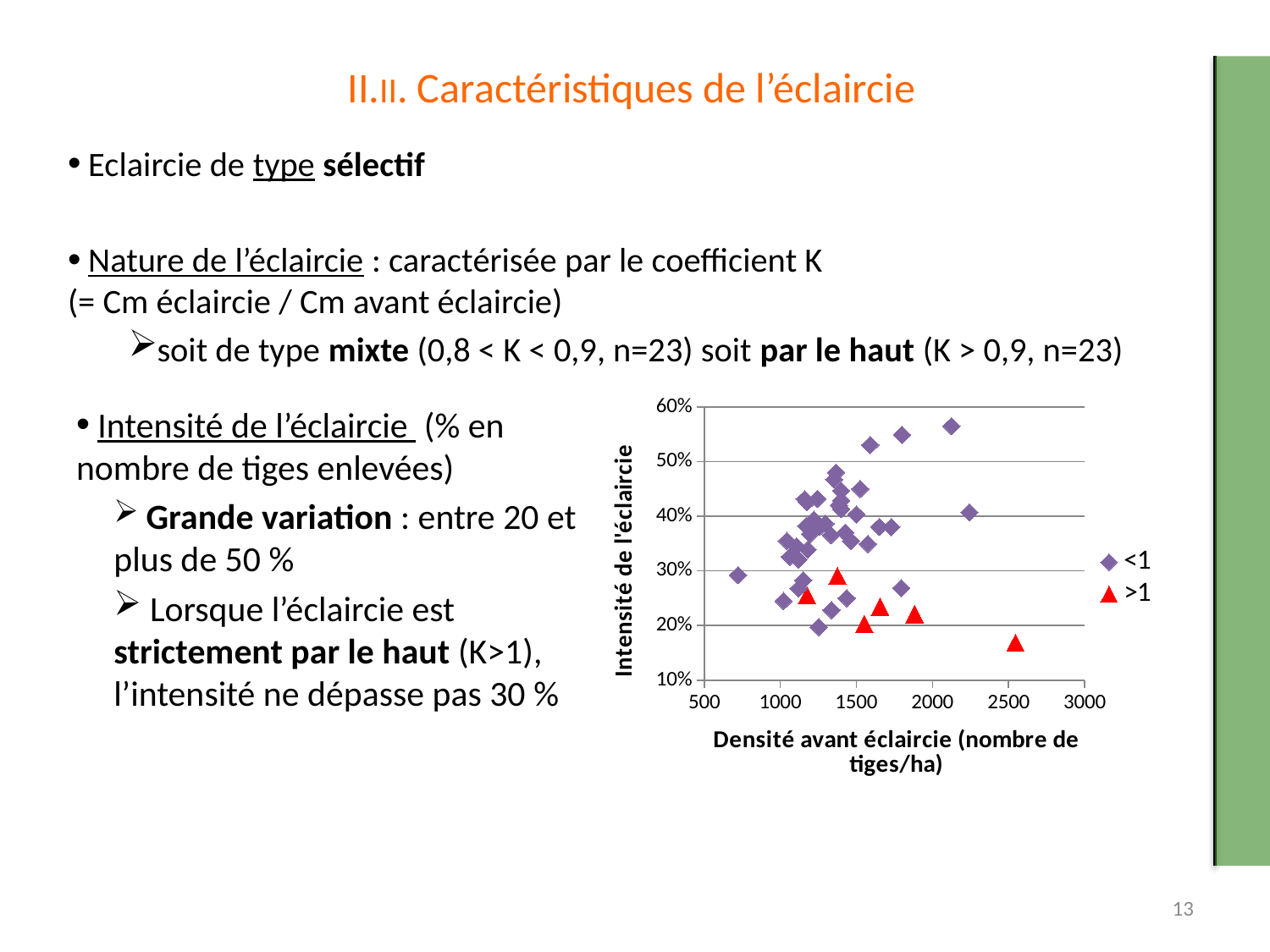
How many points are plotted for the '>1' series? 6 Is the rightmost '>1' point located at a density greater or less than 2500? greater Is the highest point of the '<1' series greater or less than 50%? greater Is the lowest point of the '>1' series greater or less than 20%? less What is the maximum value shown on the y axis? 60% What are the two series names shown in the chart legend? <1 and >1 Which series is plotted with red triangles? >1 Which series reaches the higher intensity values, '<1' or '>1'? <1 What kind of chart is shown on the slide? scatter chart How many series does the chart legend list? 2